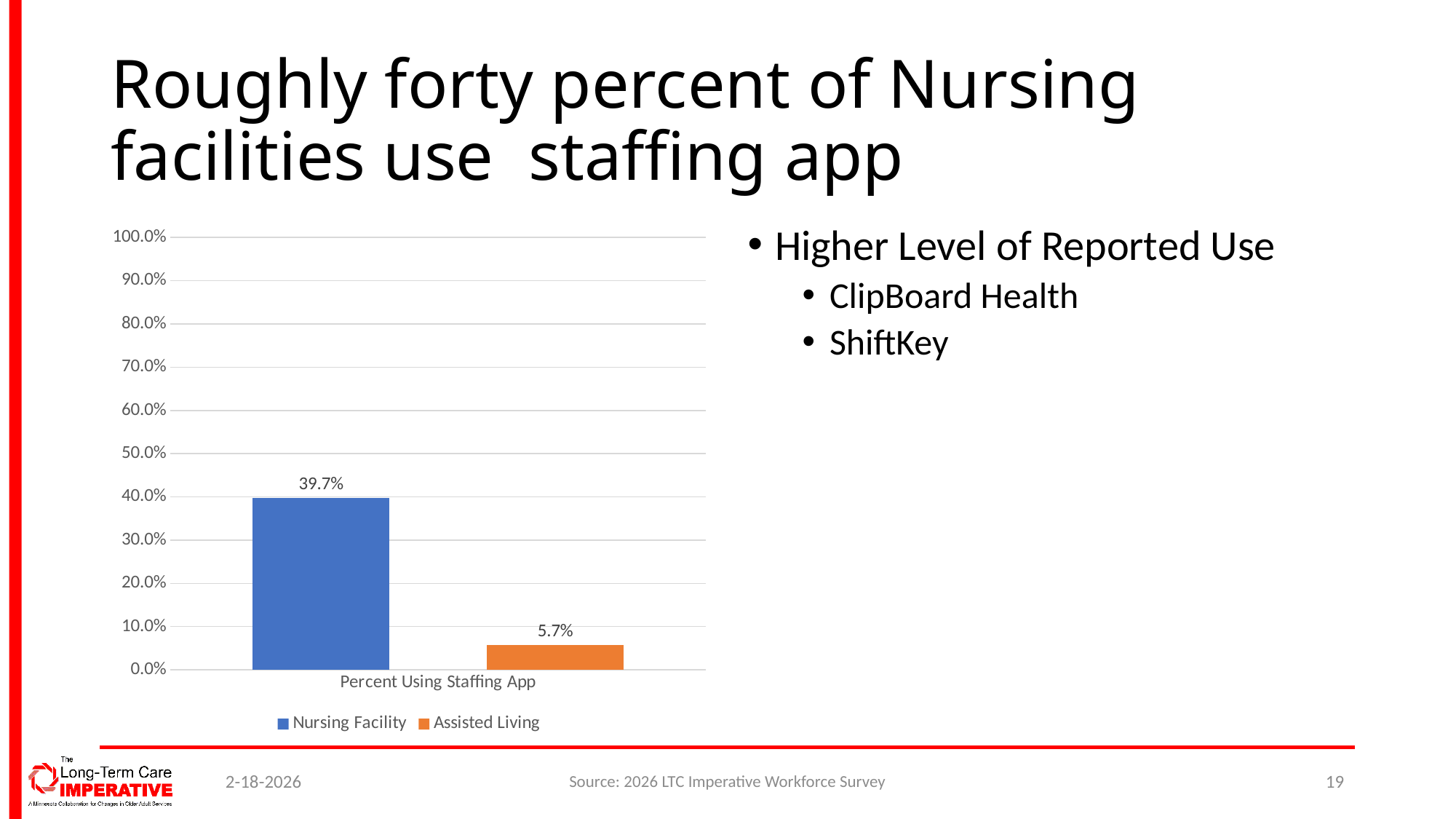
What is the difference between the Nursing Facility and Assisted Living values? 34.0% What kind of chart is shown on the slide? Bar chart What is the value for Assisted Living in the Percent Using Staffing App chart? 5.7% Is the value for Assisted Living greater or less than 10.0%? less What is the category label shown on the x axis of the chart? Percent Using Staffing App What colour is the Assisted Living bar? Orange What is the highest value shown on the y axis of the chart? 100.0% Which series has the lowest value in the chart? Assisted Living How many series does the legend list? 2 What is the value for Nursing Facility in the Percent Using Staffing App chart? 39.7% Which series has the higher value, Nursing Facility or Assisted Living? Nursing Facility Is the value for Nursing Facility greater or less than 50.0%? less